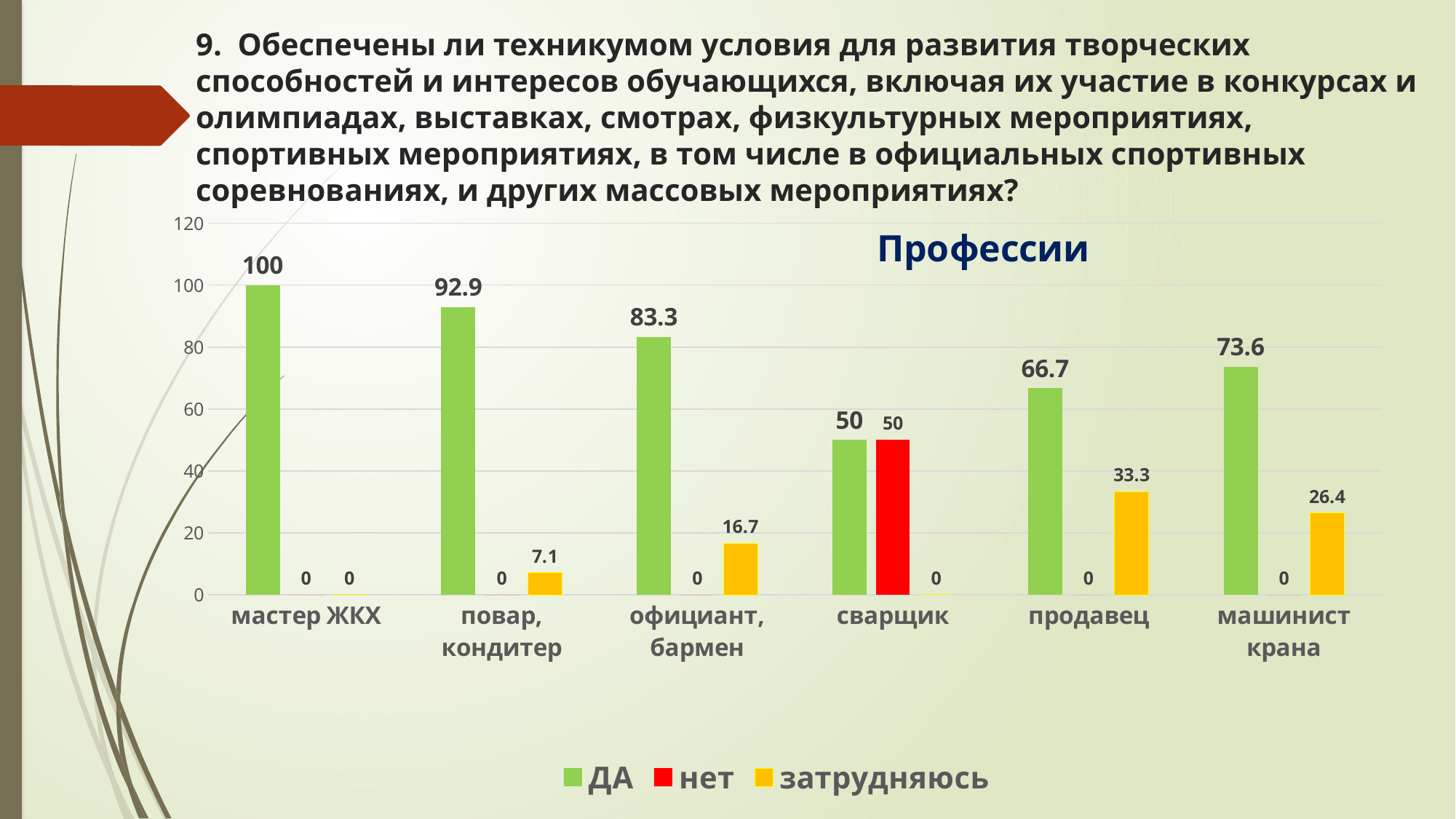
What is the value of the затрудняюсь series for продавец? 33.3 Which is larger: the затрудняюсь value for машинист крана or for официант, бармен? машинист крана What is the value of the ДА series for машинист крана? 73.6 What is the difference between the ДА values for повар, кондитер and официант, бармен? 9.6 What is the value of the нет series for сварщик? 50 Which category has the lowest value in the ДА series? сварщик What kind of chart is shown on the slide? bar chart How many series does the legend list? 3 How many categories are shown on the x axis? 6 What is the value of the ДА series for мастер ЖКХ? 100 What colour represents the нет series in the legend? red Which category has the highest value in the ДА series? мастер ЖКХ